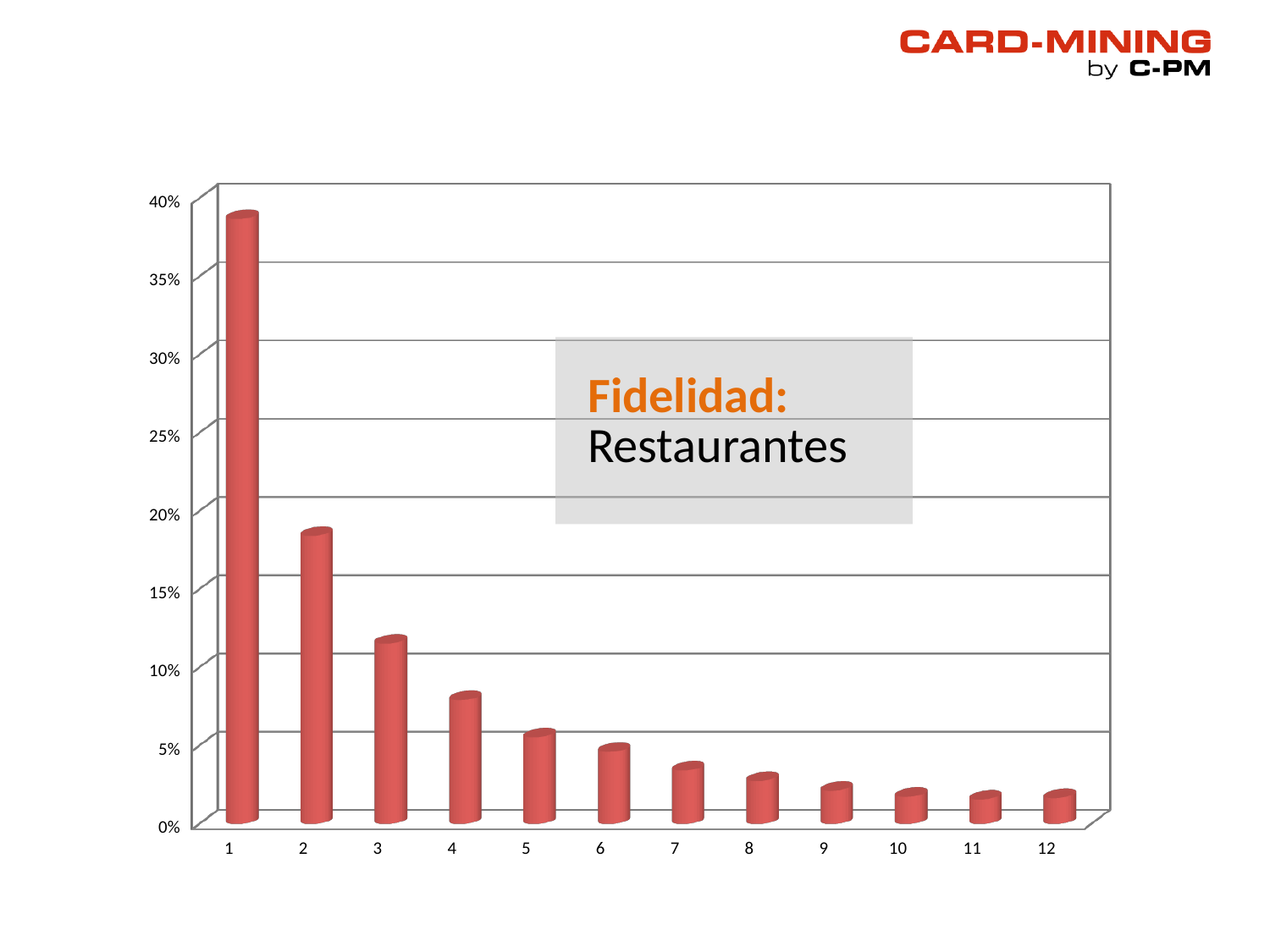
What text appears in the grey box overlaid on the chart? Fidelidad: Restaurantes How many categories are plotted along the x axis? 12 Do the values rise or fall as you move from category 1 to category 12? fall Is the value for category 7 greater or less than 5%? less Is the value for category 4 greater or less than 10%? less Is the value for category 2 greater or less than 15%? greater What kind of chart is shown on the slide? bar chart Which is larger, the value for category 3 or the value for category 5? category 3 Which category has the highest value? 1